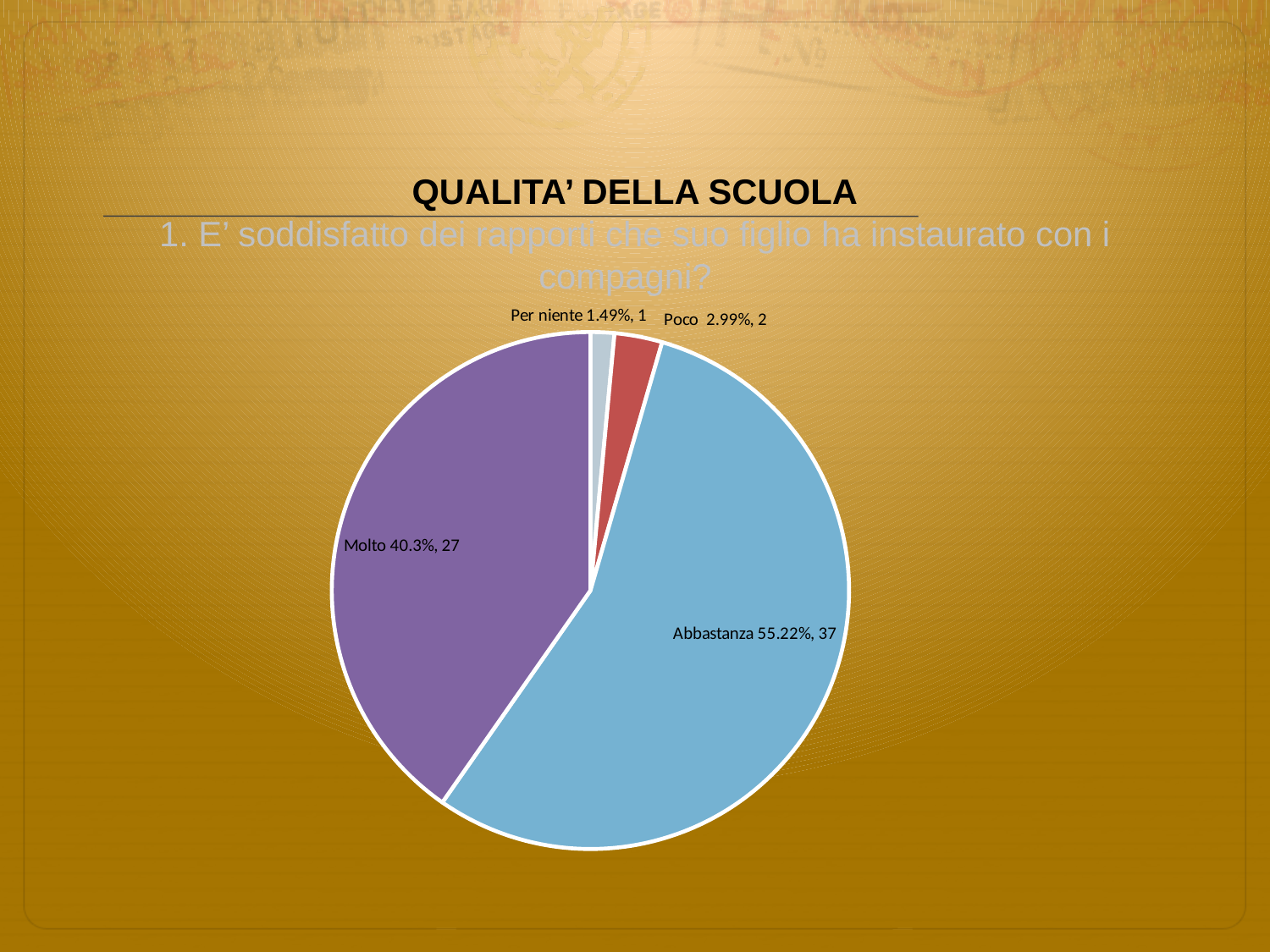
What percentage share does the Molto slice have? 40.3% Which category has the largest slice? Abbastanza What percentage share does the Per niente slice have? 1.49% Which category has the smallest slice? Per niente How many responses does the Abbastanza slice represent? 37 Which has more responses, Poco or Per niente? Poco What percentage share does the Poco slice have? 2.99% How many slices does the pie chart have? 4 How many responses does the Molto slice represent? 27 What is the difference in response counts between Abbastanza and Molto? 10 What kind of chart is shown on the slide? pie chart